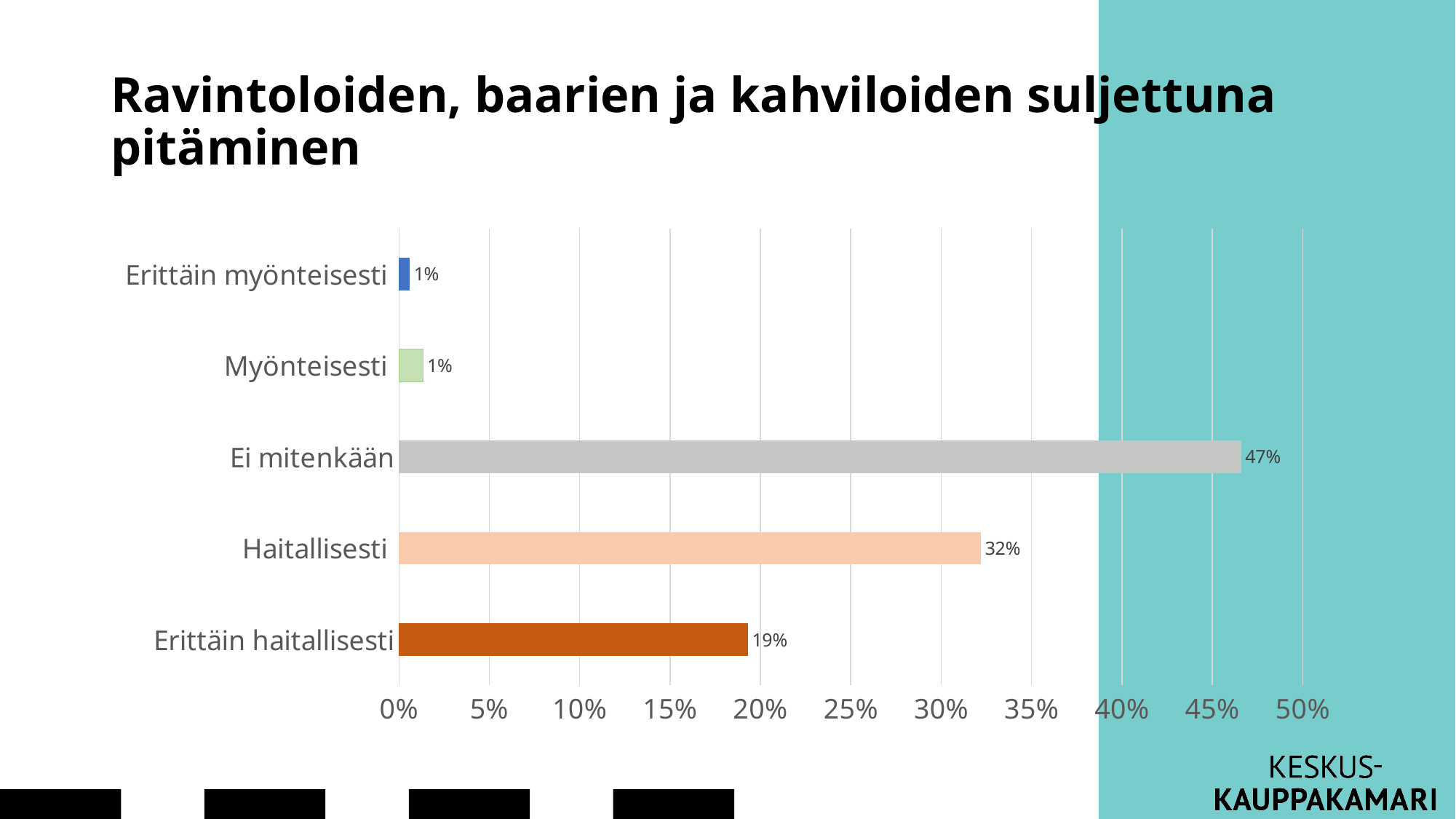
What is the difference between the values for Haitallisesti and Erittäin haitallisesti? 13% Is the value for Ei mitenkään greater or less than 40%? greater How many categories are shown in the chart? 5 What is the value for Haitallisesti? 32% Which is larger, the value for Haitallisesti or the value for Erittäin haitallisesti? Haitallisesti What is the value for Myönteisesti? 1% What is the value for Ei mitenkään? 47% What kind of chart is shown on the slide? Bar chart What is the difference between the values for Ei mitenkään and Haitallisesti? 15% What is the value for Erittäin haitallisesti? 19% What is the title of the slide? Ravintoloiden, baarien ja kahviloiden suljettuna pitäminen Which category has the highest value? Ei mitenkään